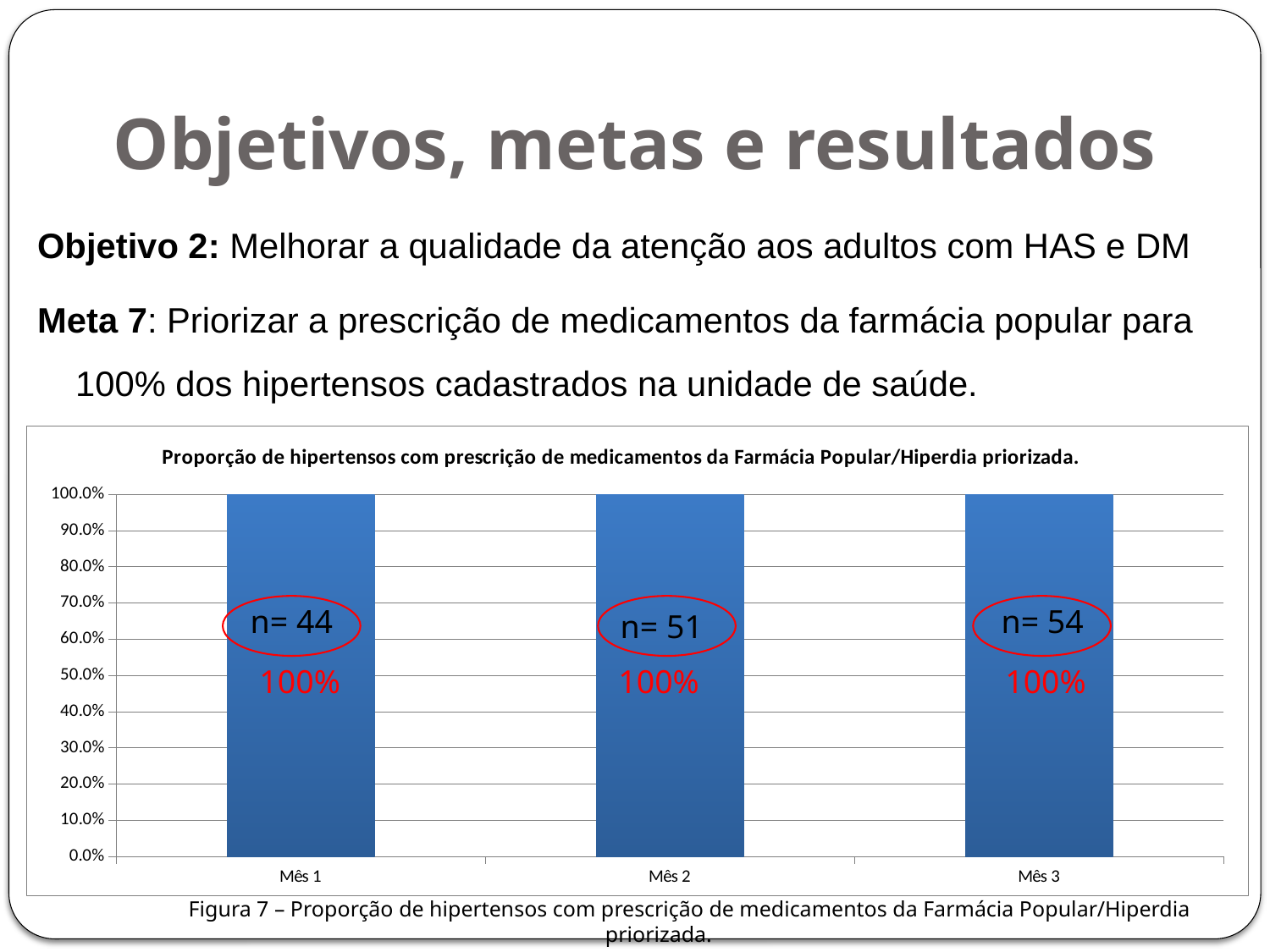
What is the value for Mês 2? 100% What is the n value shown on the bar for Mês 1? n= 44 Do the values rise, fall or stay the same from Mês 1 to Mês 3? stay the same What is the highest value shown on the y axis? 100.0% What is the n value shown on the bar for Mês 2? n= 51 What is the difference between the values for Mês 3 and Mês 1? 0% What is the title of the chart? Proporção de hipertensos com prescrição de medicamentos da Farmácia Popular/Hiperdia priorizada. How many categories are shown on the x axis? 3 What is the value for Mês 3? 100% What is the n value shown on the bar for Mês 3? n= 54 What is the value for Mês 1? 100% What kind of chart is shown on the slide? bar chart